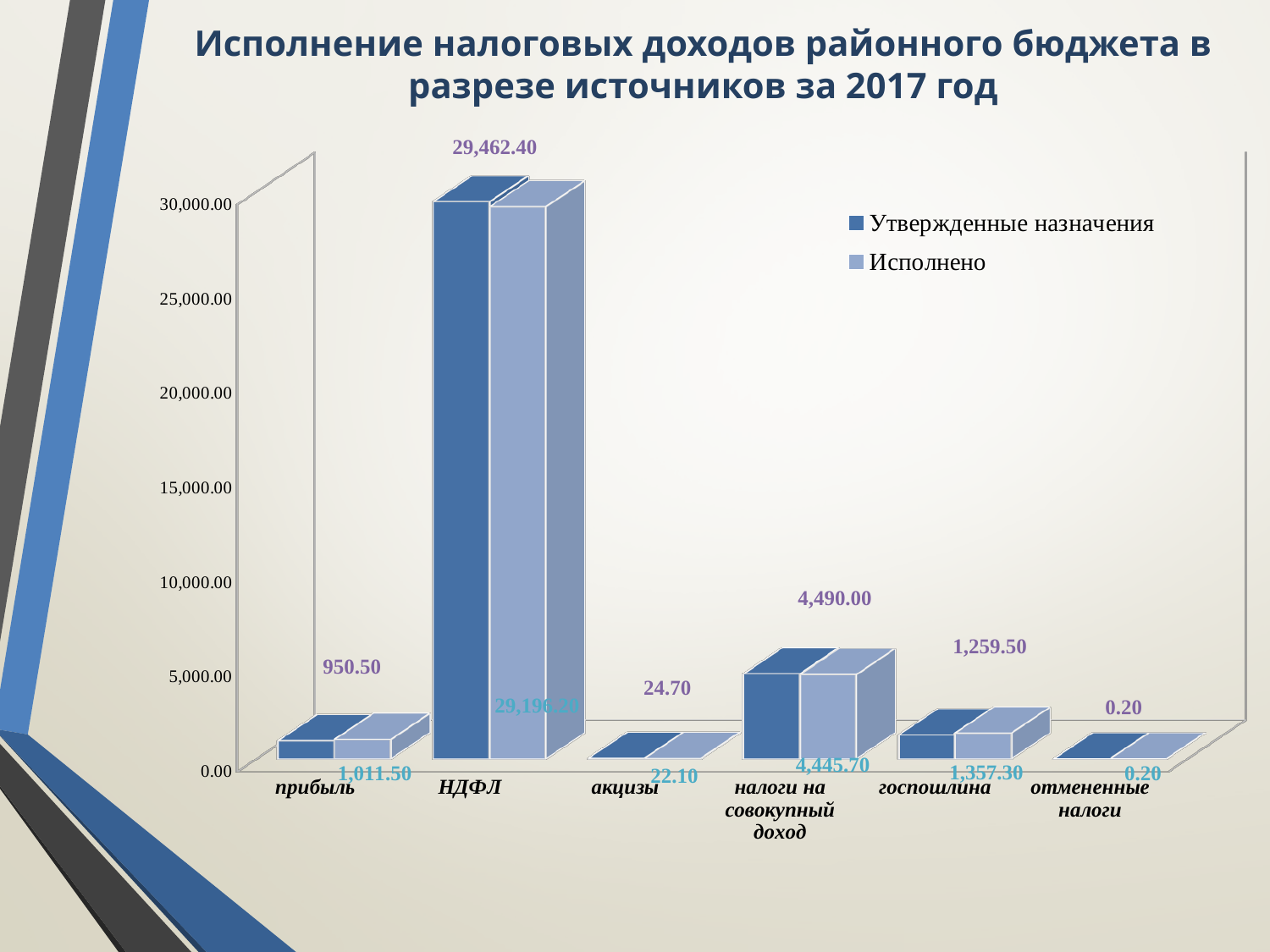
Which category has the highest Утвержденные назначения value? НДФЛ What is the Исполнено value for госпошлина? 1,357.30 For налоги на совокупный доход, which is larger: Утвержденные назначения or Исполнено? Утвержденные назначения How many categories are shown on the x axis? 6 What kind of chart is shown on the slide? Bar chart What is the Утвержденные назначения value for НДФЛ? 29,462.40 Which category has the lowest Утвержденные назначения value? отмененные налоги What is the Утвержденные назначения value for налоги на совокупный доход? 4,490.00 What is the difference between the Утвержденные назначения and Исполнено values for госпошлина? 97.80 What is the Исполнено value for прибыль? 1,011.50 How many series does the legend list? 2 What is the Исполнено value for акцизы? 22.10